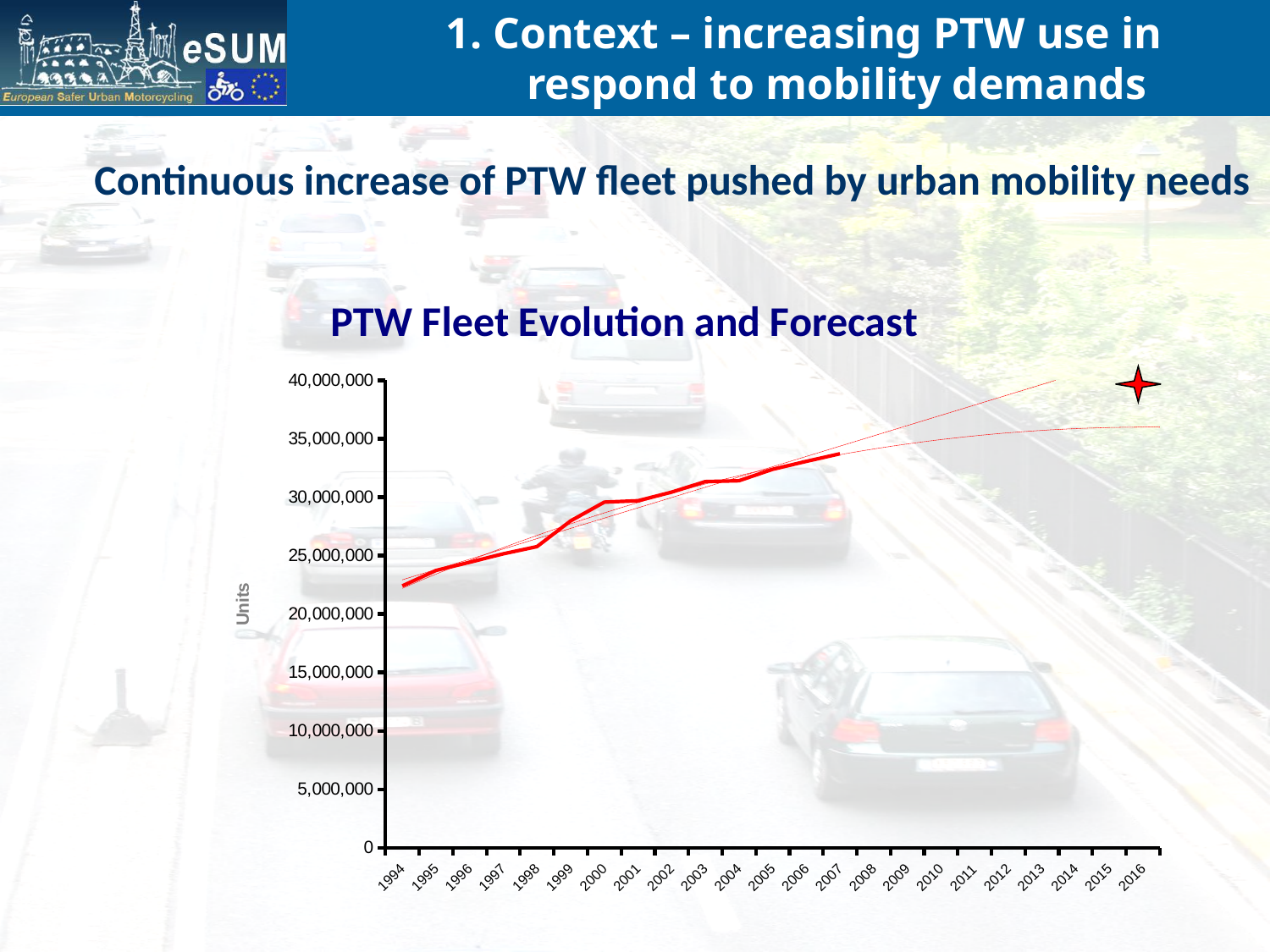
Is the value for 1994 greater or less than 25,000,000? less Which year has the highest value on the thick red line? 2007 Is the value for 2004 greater or less than 30,000,000? greater What is the title of the chart? PTW Fleet Evolution and Forecast How many years are labelled on the x axis? 23 What kind of chart is shown on the slide? line chart What is the label on the vertical axis of the chart? Units Which year has the lowest value on the thick red line? 1994 Which year has the larger value, 1994 or 2007? 2007 Is the value for 1994 greater or less than 20,000,000? greater Does the PTW fleet rise or fall from 1994 to 2007 along the x axis? rise